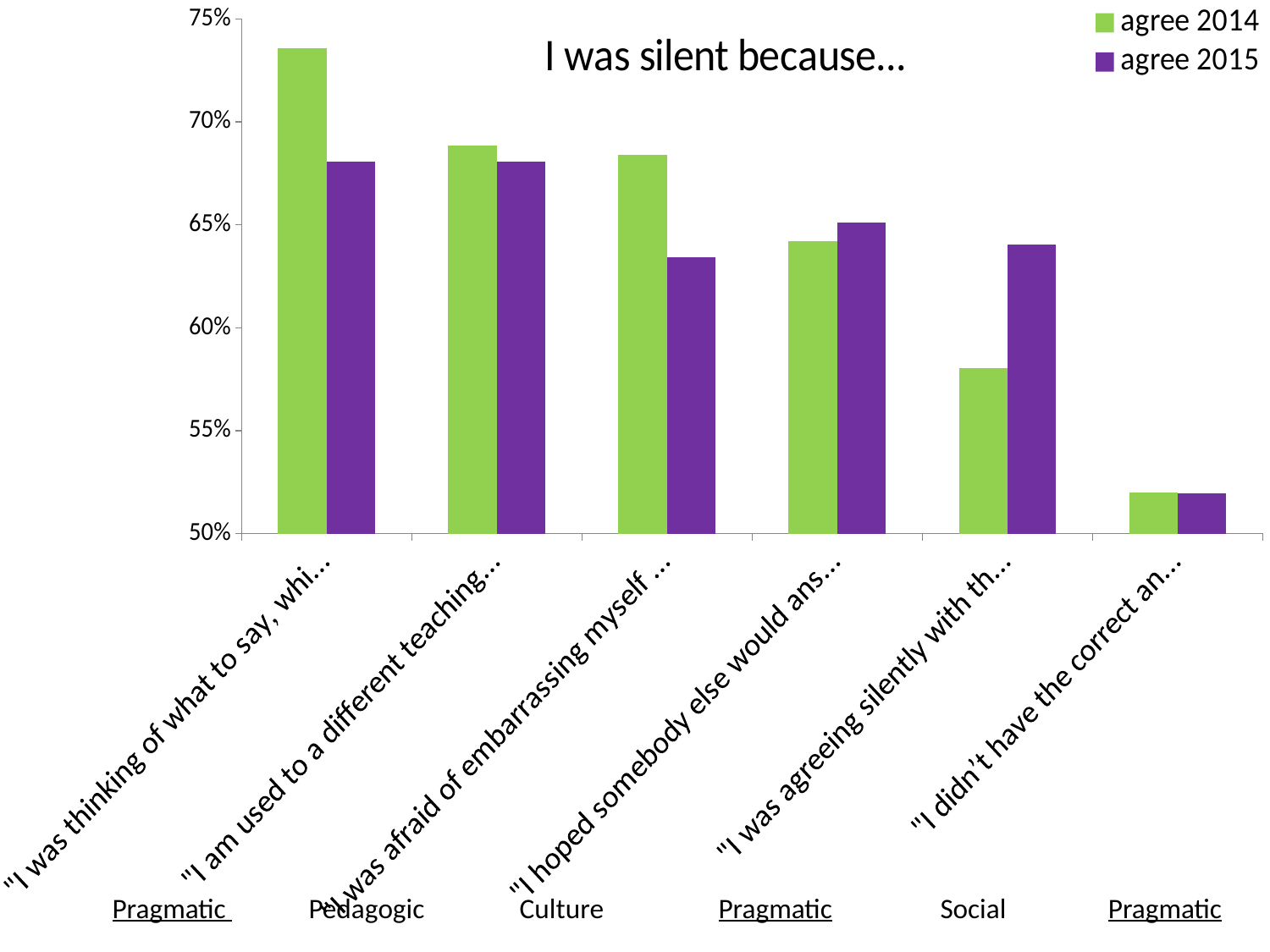
Is the 'agree 2014' value for "I was agreeing silently with th…" greater or less than 60%? less How many categories (statements) are plotted along the x axis? 6 Which category has the highest 'agree 2014' value? "I was thinking of what to say, whi…" (the first category) How many series does the legend list? 2 For "I was agreeing silently with th…", which is larger: 'agree 2014' or 'agree 2015'? agree 2015 What is the title of the chart? I was silent because… Which category has the lowest 'agree 2015' value? "I didn't have the correct an…" (the last category) What kind of chart is shown on the slide? bar chart Which colour represents the 'agree 2015' series? purple Is the 'agree 2015' value for "I was afraid of embarrassing myself …" greater or less than 65%? less Do the 'agree 2014' values generally rise or fall from left to right across the categories? fall Is the 'agree 2014' value for "I was thinking of what to say, whi…" greater or less than 70%? greater